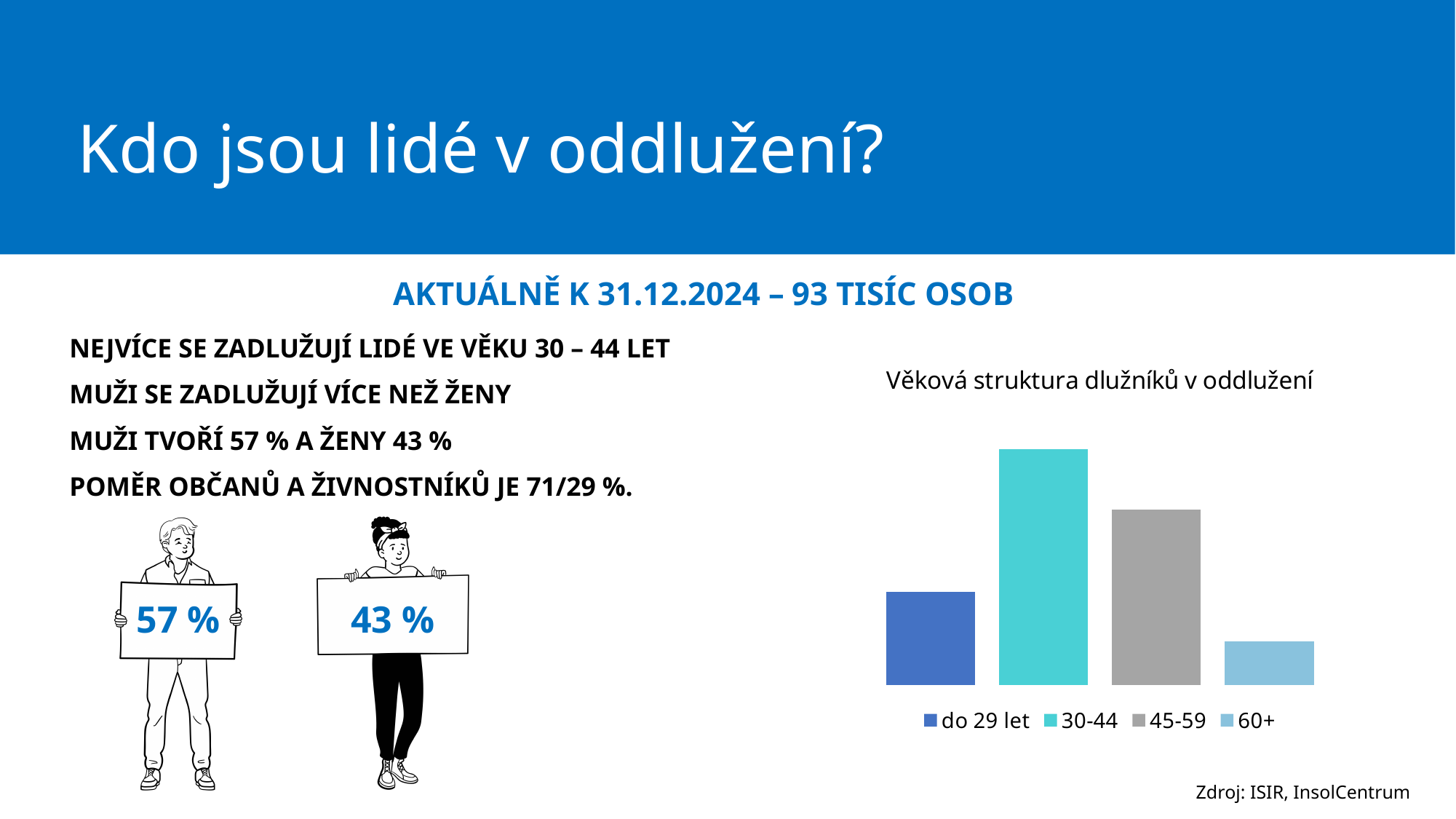
Which legend entry in the chart is shown in grey? 45-59 Which age group has the second-highest bar in the chart? 45-59 How many entries does the chart's legend list? 4 What kind of chart is shown on the slide? bar chart Which bar is taller in the chart: do 29 let or 60+? do 29 let Which bar is taller in the chart: 30-44 or 45-59? 30-44 How many bars does the chart show? 4 What is the title of the chart on the slide? Věková struktura dlužníků v oddlužení Which bar is taller in the chart: 45-59 or do 29 let? 45-59 Which age group has the highest bar in the chart? 30-44 Which age group has the lowest bar in the chart? 60+